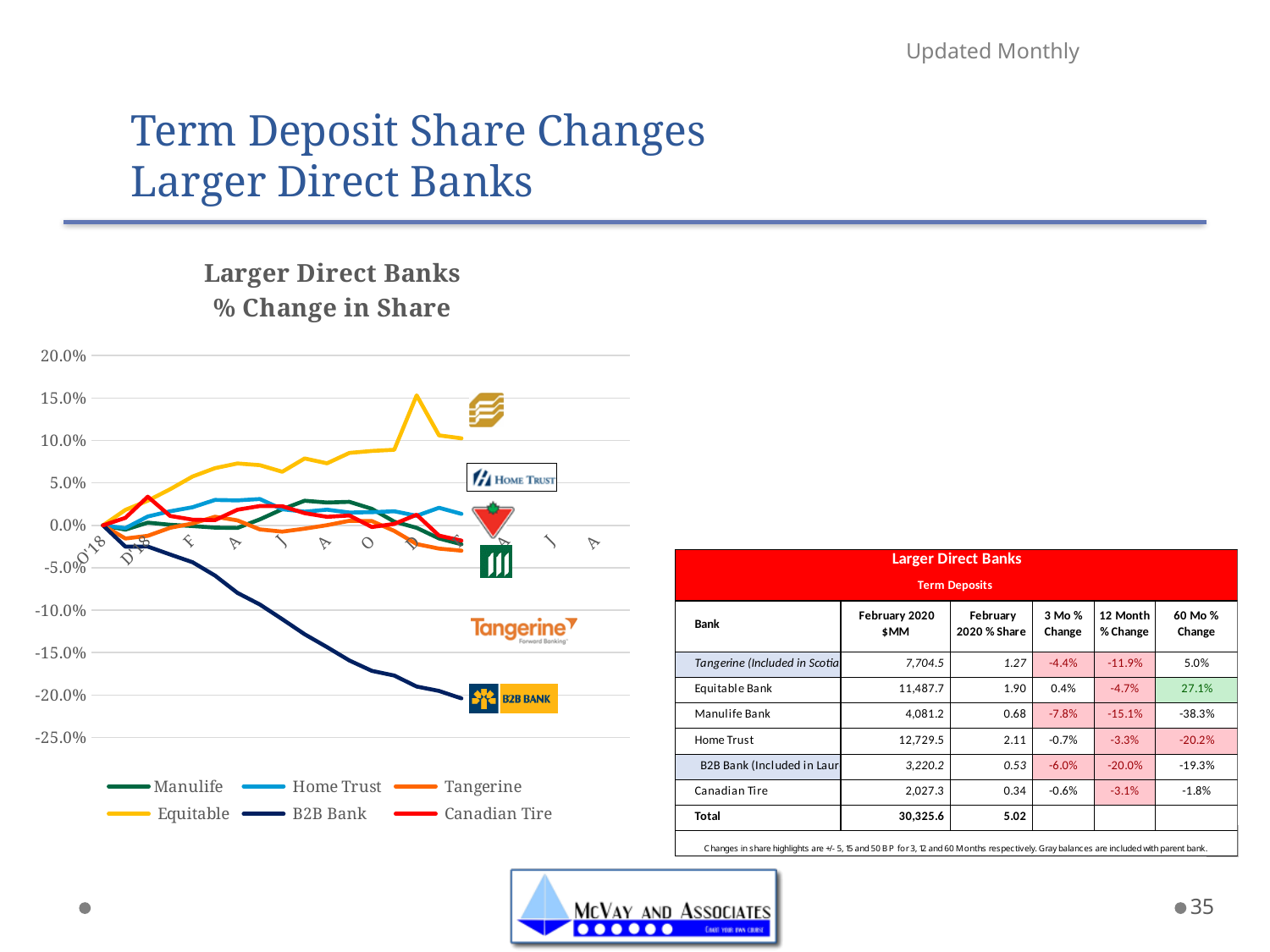
Is the final value for Manulife greater or less than 0.0%? less Which series has the lowest value at the right end of the chart? B2B Bank Does the Equitable line overall rise or fall along the x axis? Rise Which series has the highest value at the right end of the chart? Equitable Is the final value for Equitable greater or less than 5.0%? greater Does the B2B Bank line rise or fall along the x axis? Fall How many series does the legend of the chart list? 6 What is the title of the chart? Larger Direct Banks % Change in Share Is the final value for B2B Bank greater or less than -15.0%? less What kind of chart is shown on the slide? Line chart At the right end of the chart, which is larger: the value for Equitable or the value for B2B Bank? Equitable